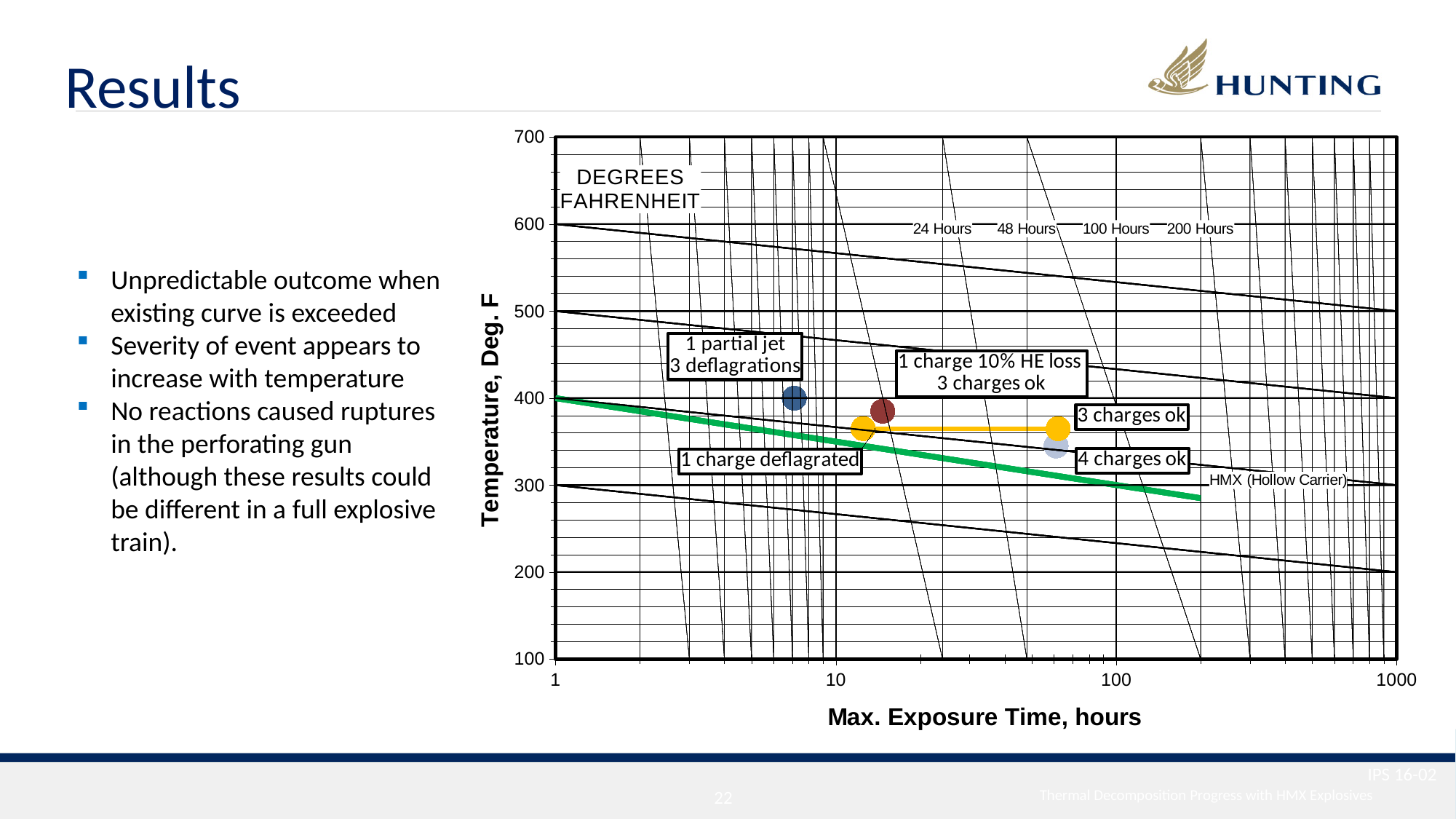
Is the Max. Exposure Time of the point labelled '3 charges ok' greater or less than 10 hours? greater What is the label of the x axis of the chart? Max. Exposure Time, hours Does the green HMX (Hollow Carrier) curve rise or fall as Max. Exposure Time increases? fall What is the label of the y axis of the chart? Temperature, Deg. F What is the highest temperature value shown on the y axis of the chart? 700 Is the temperature of the point labelled '1 charge 10% HE loss 3 charges ok' greater or less than 300? greater Is the temperature of the point labelled '1 partial jet 3 deflagrations' greater or less than 300? greater Which plotted point has the longer Max. Exposure Time: '1 charge deflagrated' or '3 charges ok'? 3 charges ok Which plotted point has the higher temperature: '1 partial jet 3 deflagrations' or '4 charges ok'? 1 partial jet 3 deflagrations